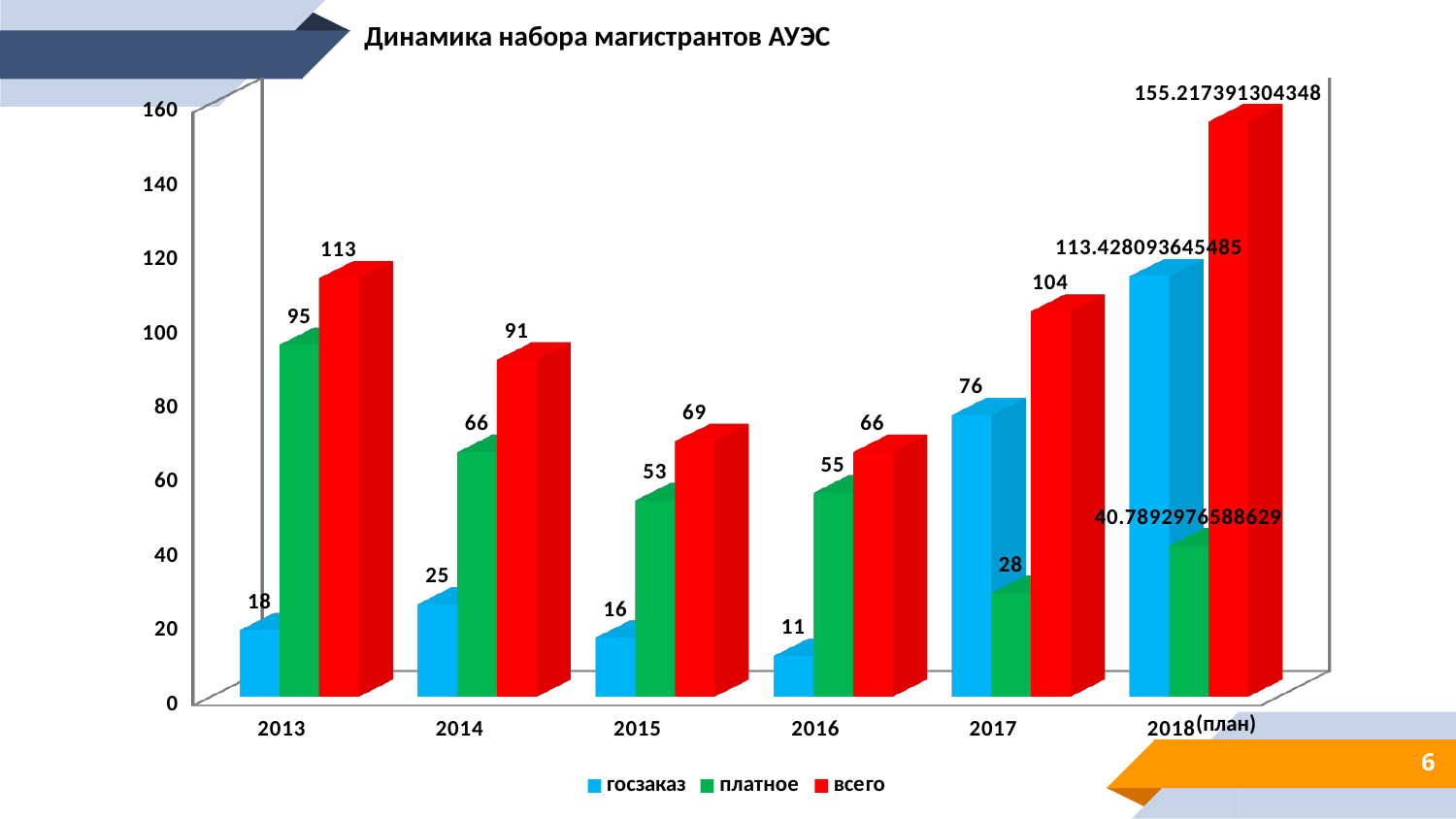
What is the value of всего for 2018(план)? 155.217391304348 Which year has the lowest value for госзаказ? 2016 Which year has the highest value for платное? 2013 What is the title of the chart? Динамика набора магистрантов АУЭС What is the value of всего for 2017? 104 What is the value of госзаказ for 2013? 18 What is the value of платное for 2014? 66 How many years are shown on the x axis? 6 What is the difference between всего for 2013 and всего for 2014? 22 Which is larger: платное for 2015 or платное for 2016? платное for 2016 What kind of chart is shown on the slide? bar chart How many series does the legend list? 3